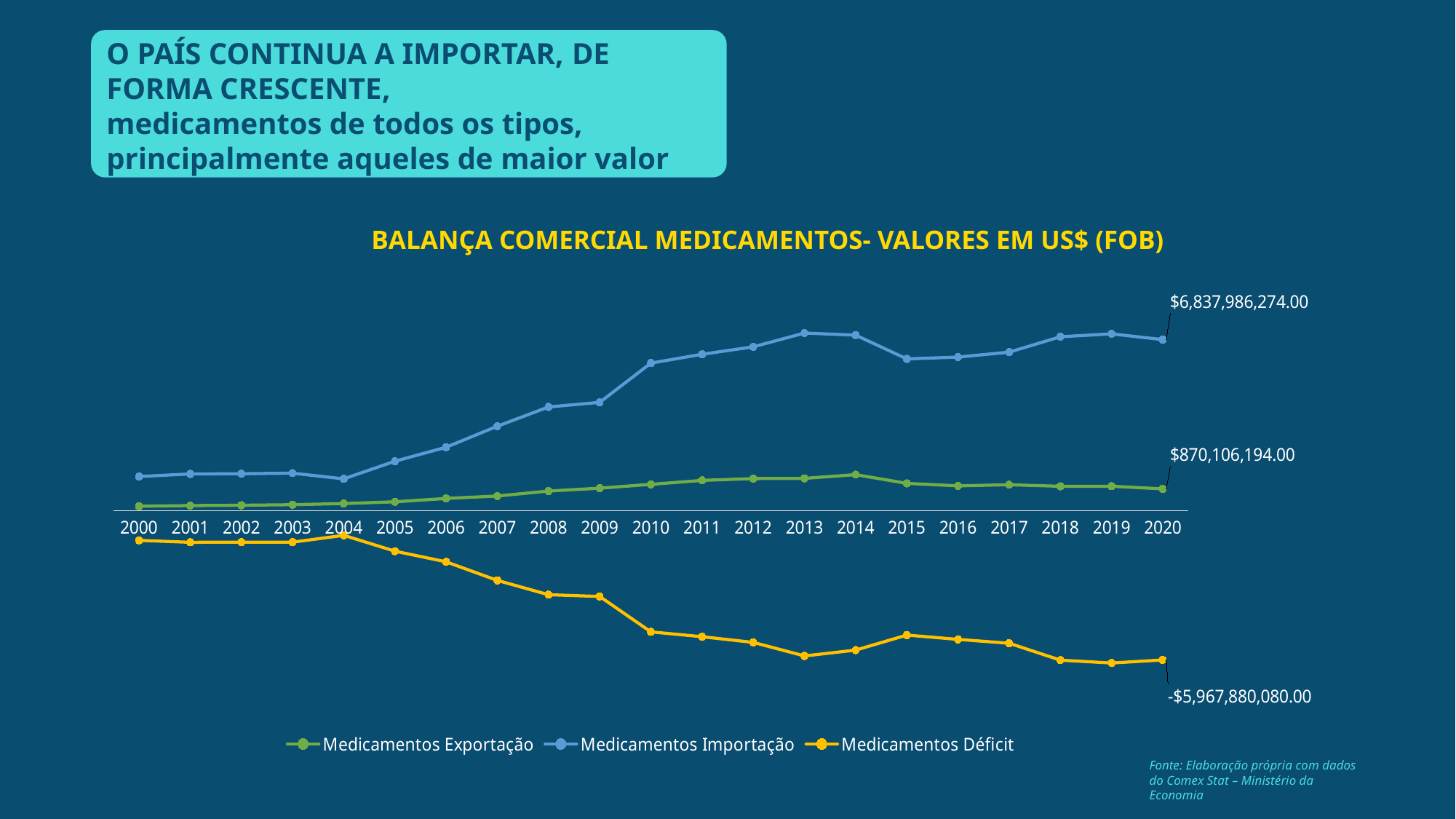
What is the value of Medicamentos Exportação in 2020? $870,106,194.00 Does the Medicamentos Importação line rise or fall from 2000 to 2020? rises What is the difference between Medicamentos Importação and Medicamentos Exportação in 2020? $5,967,880,080.00 What kind of chart is shown on the slide? line chart What is the title of the chart? BALANÇA COMERCIAL MEDICAMENTOS- VALORES EM US$ (FOB) In 2020, which is larger: Medicamentos Importação or Medicamentos Exportação? Medicamentos Importação Which series has the highest value in 2020? Medicamentos Importação Does the Medicamentos Déficit line rise or fall from 2004 to 2020? falls What is the value of Medicamentos Déficit in 2020? -$5,967,880,080.00 What is the value of Medicamentos Importação in 2020? $6,837,986,274.00 How many years are plotted along the x axis? 21 How many series does the legend list? 3